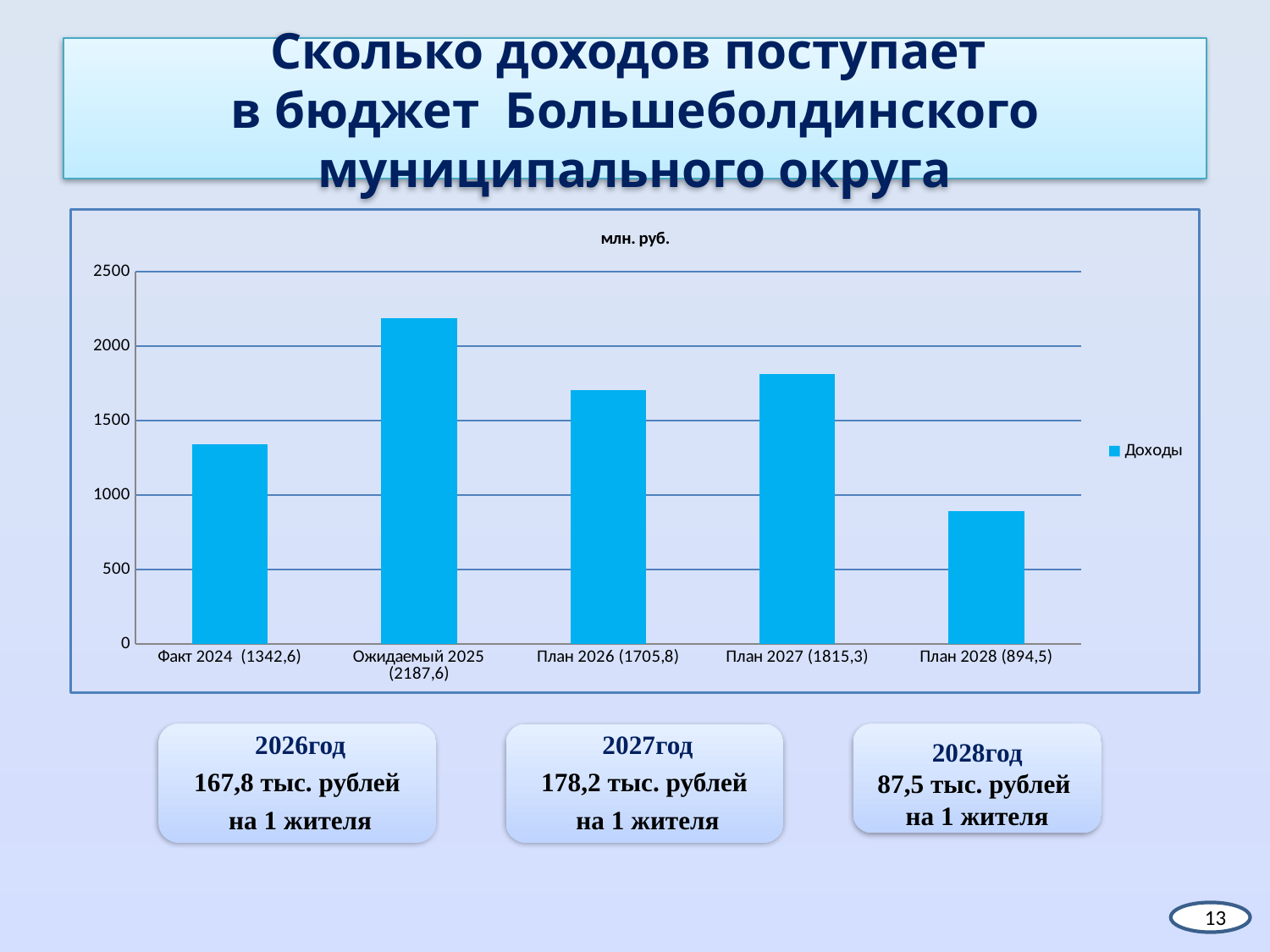
Is the value for План 2028 greater or less than 1000? less What is the difference between План 2027 and План 2026? 109,5 What is the difference between Ожидаемый 2025 and Факт 2024? 845 What is the value for План 2028? 894,5 What is the value for Факт 2024? 1342,6 How many series does the legend list? 1 What kind of chart is shown? bar chart What is the value for План 2027? 1815,3 Which is larger, План 2026 or План 2027? План 2027 How many categories are shown on the x axis? 5 Which category has the highest value? Ожидаемый 2025 Which category has the lowest value? План 2028